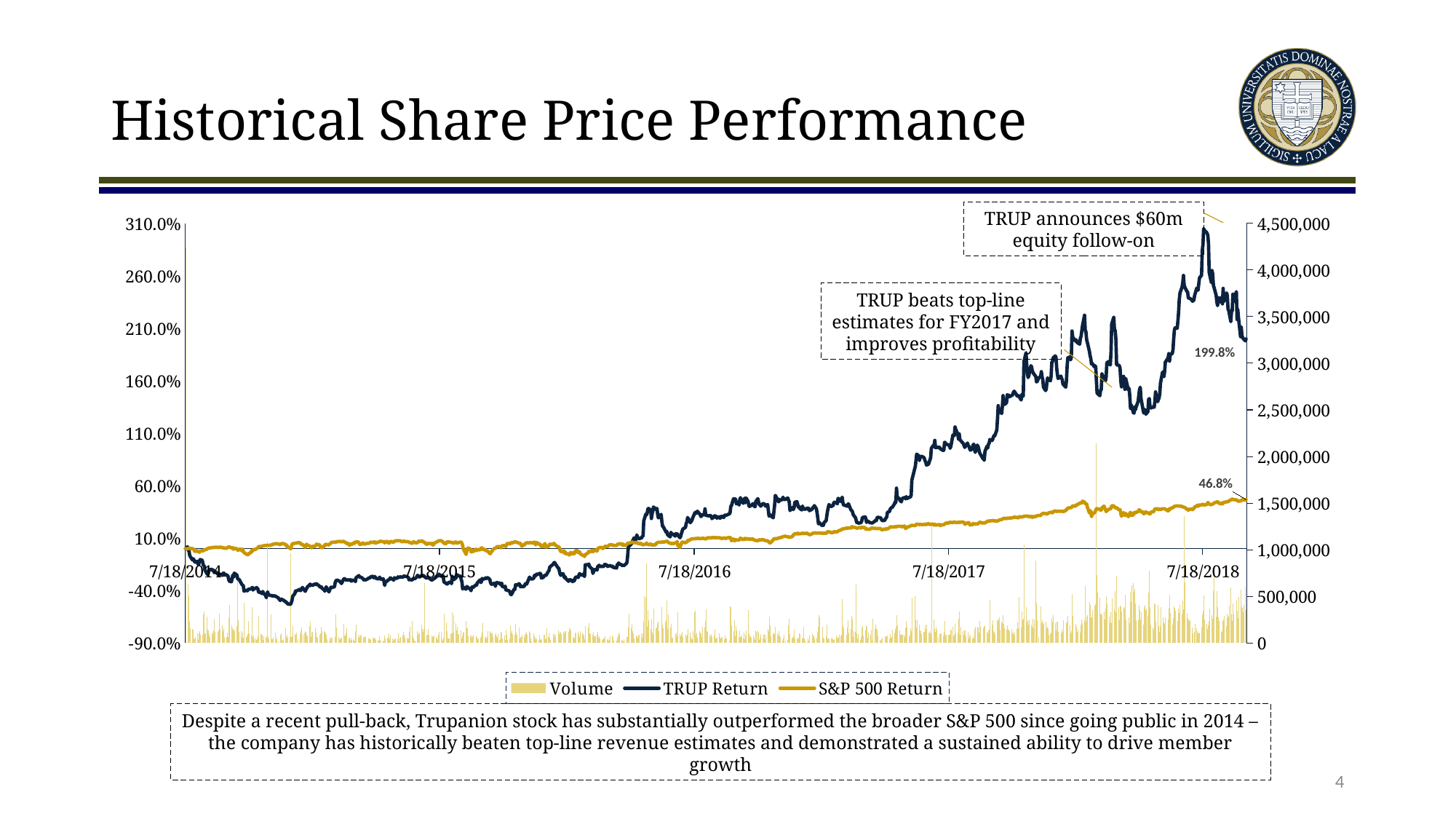
What kind of chart is used to plot the TRUP Return and S&P 500 Return series? line chart Overall, does the TRUP Return line rise or fall from 7/18/2014 to 7/18/2018? rise At the right end of the chart, which series has the larger labelled return, TRUP Return or S&P 500 Return? TRUP Return What is the labelled final value of the S&P 500 Return series? 46.8% What kind of chart is used to plot the Volume series? bar chart How many series does the legend list? 3 How many date labels are shown on the x axis? 5 What is the labelled final value of the TRUP Return series? 199.8% By how many percentage points does the labelled final TRUP Return exceed the labelled final S&P 500 Return? 153.0% Is the lowest value of the TRUP Return line, reached in early 2015, greater or less than -40.0%? less Is the peak value of the TRUP Return line greater or less than 260.0%? greater What is the title of the slide containing the chart? Historical Share Price Performance